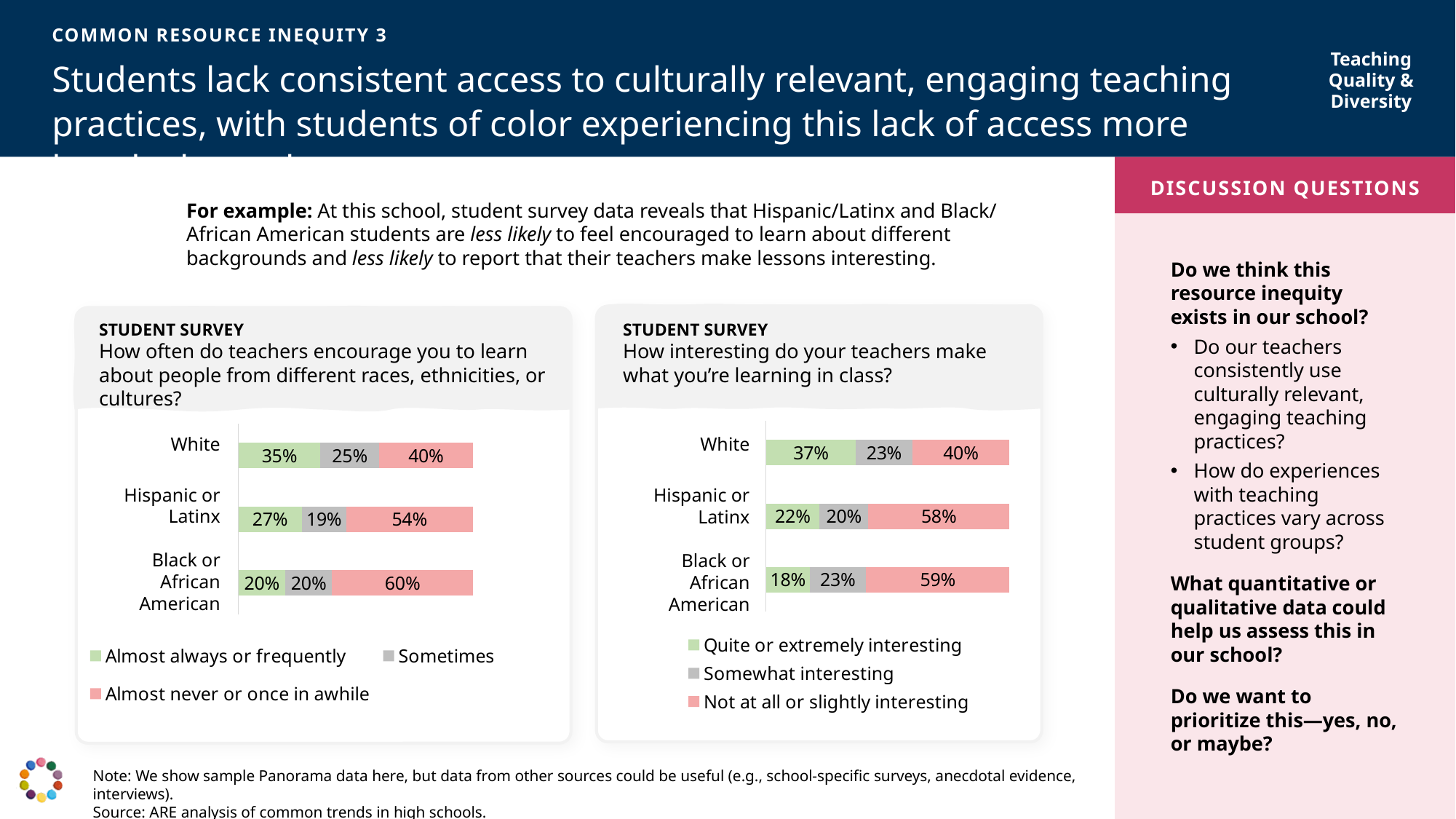
In the left chart (how often teachers encourage learning about different races, ethnicities, or cultures), what percentage of Black or African American students answered 'Almost never or once in awhile'? 60% In the right chart (how interesting teachers make what you're learning), which student group has the lowest 'Quite or extremely interesting' share? Black or African American How many series does the legend of the right chart (how interesting teachers make what you're learning) list? 3 In the right chart (how interesting teachers make what you're learning), is the 'Quite or extremely interesting' share larger for White students or for Hispanic or Latinx students? White In the left chart (how often teachers encourage learning about different races, ethnicities, or cultures), what is the difference between the 'Almost never or once in awhile' shares for Hispanic or Latinx and White students? 14% What kind of chart is the left chart (how often teachers encourage learning about different races, ethnicities, or cultures)? Stacked bar chart In the left chart (how often teachers encourage learning about different races, ethnicities, or cultures), which student group has the highest 'Almost never or once in awhile' share? Black or African American In the right chart (how interesting teachers make what you're learning), what percentage of Hispanic or Latinx students answered 'Not at all or slightly interesting'? 58% In the right chart (how interesting teachers make what you're learning), what percentage of Black or African American students answered 'Quite or extremely interesting'? 18% How many student groups are shown in the left chart (how often teachers encourage learning about different races, ethnicities, or cultures)? 3 In the left chart (how often teachers encourage learning about different races, ethnicities, or cultures), what percentage of White students answered 'Almost always or frequently'? 35% In the right chart (how interesting teachers make what you're learning), what is the difference between the 'Quite or extremely interesting' shares for White and Black or African American students? 19%